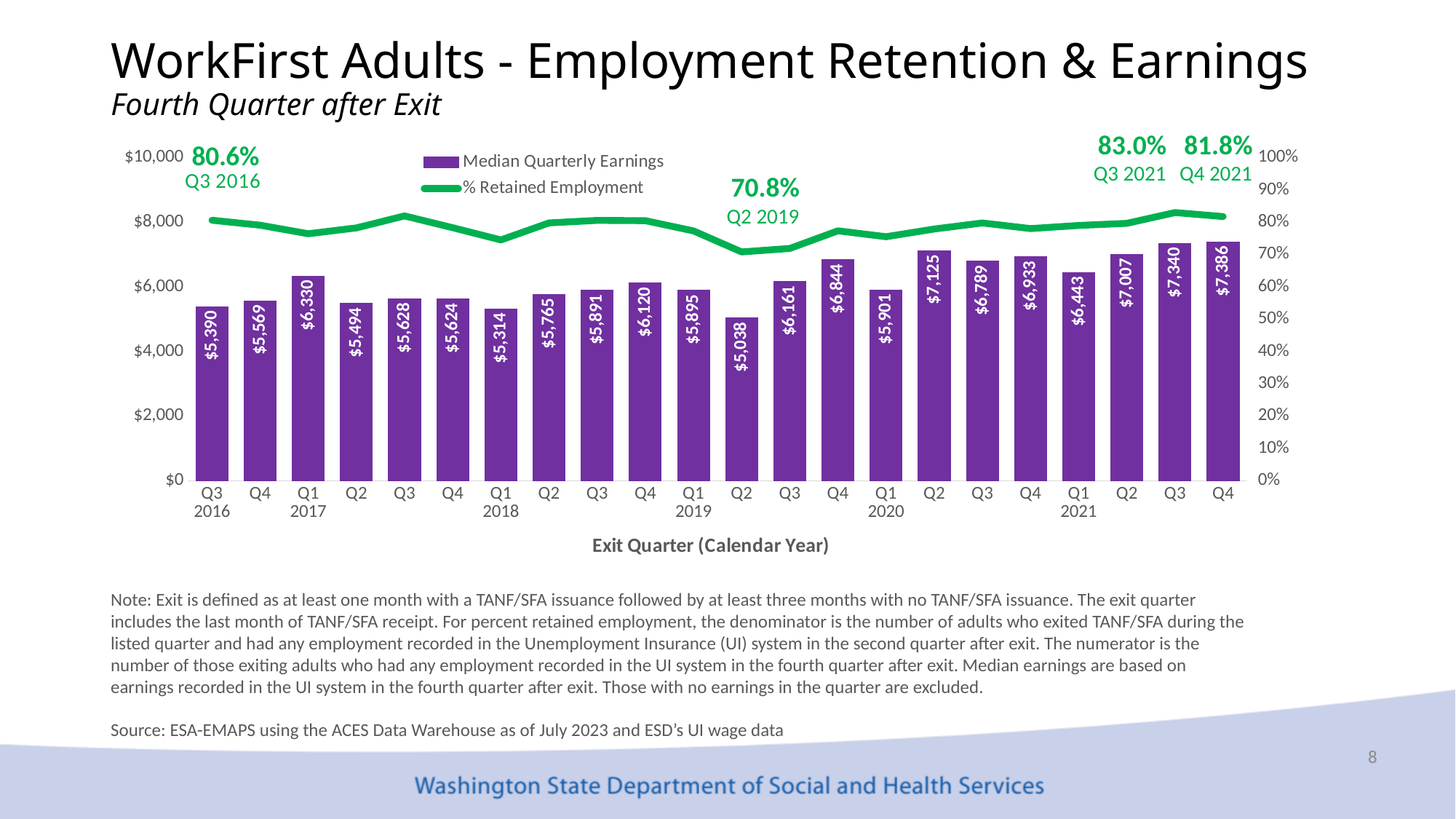
Which exit quarter has the lowest Median Quarterly Earnings? Q2 2019 How many exit quarters are shown on the x axis? 22 What is the Median Quarterly Earnings value for Q1 2017? $6,330 What is the % Retained Employment value labeled for Q2 2019? 70.8% What kind of chart is used to show Median Quarterly Earnings? bar chart Which has higher Median Quarterly Earnings, Q4 2019 or Q2 2020? Q2 2020 Which exit quarter has the highest Median Quarterly Earnings? Q4 2021 What is the difference in Median Quarterly Earnings between Q4 2021 and Q3 2016? $1,996 What is the % Retained Employment value labeled for Q3 2021? 83.0% What is the title of the x axis? Exit Quarter (Calendar Year) How many series does the legend list? 2 Is the % Retained Employment value for Q1 2018 greater or less than 80%? less